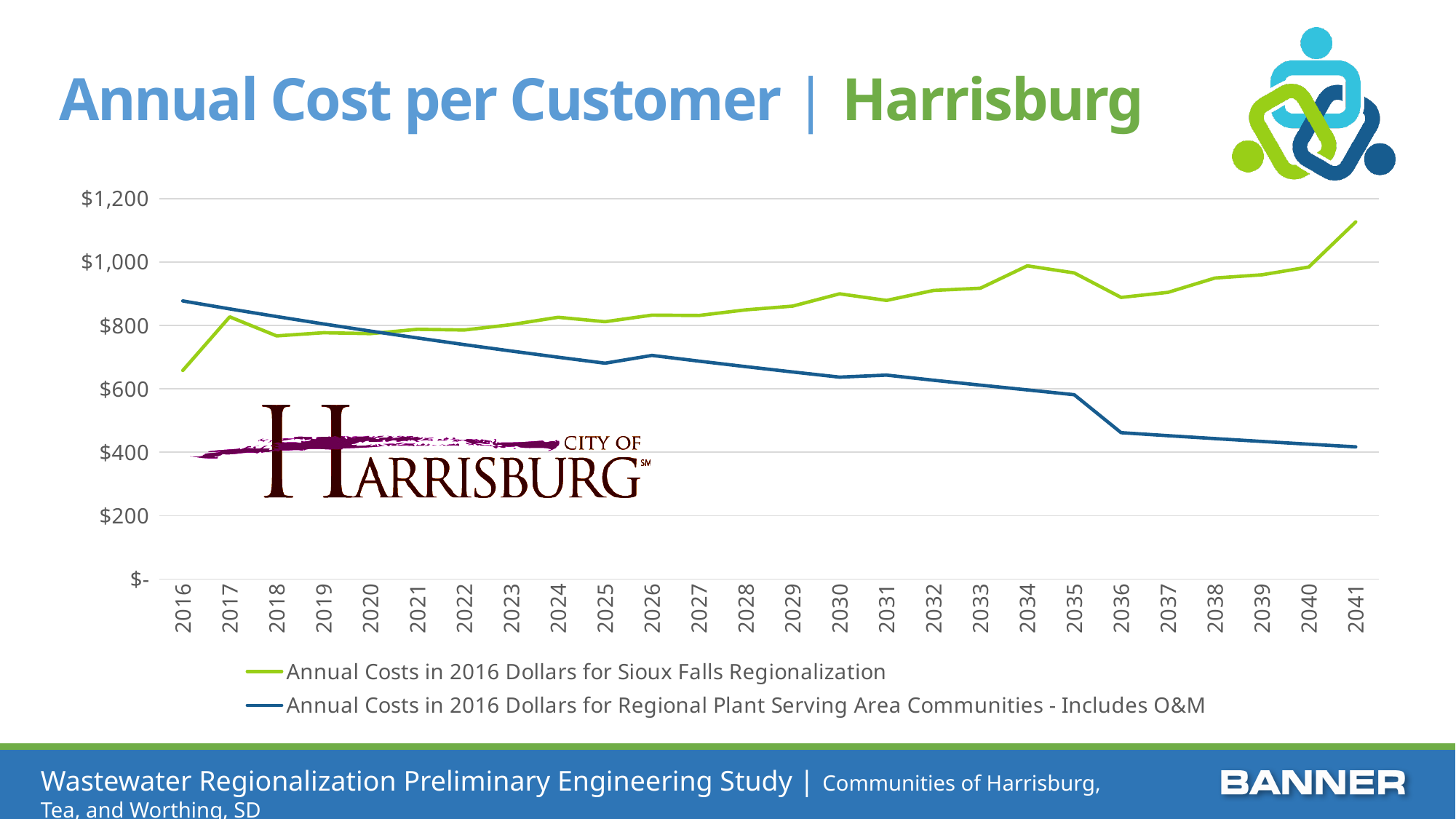
What colour is the line for Annual Costs in 2016 Dollars for Sioux Falls Regionalization? green Is the value for Sioux Falls Regionalization in 2041 greater or less than $1,000? greater In 2016, which series has the higher value: Sioux Falls Regionalization or Regional Plant Serving Area Communities? Regional Plant Serving Area Communities How many years are plotted along the x axis? 26 Is the value for Regional Plant Serving Area Communities in 2041 greater or less than $600? less What kind of chart is shown on the slide? line chart In which year is the Sioux Falls Regionalization series at its highest? 2041 Does the Annual Costs in 2016 Dollars for Regional Plant Serving Area Communities - Includes O&M series generally rise or fall from 2016 to 2041? fall How many series does the legend list? 2 In which year is the Sioux Falls Regionalization series at its lowest? 2016 In which year is the Regional Plant Serving Area Communities series at its highest? 2016 Does the Annual Costs in 2016 Dollars for Sioux Falls Regionalization series generally rise or fall from 2016 to 2041? rise